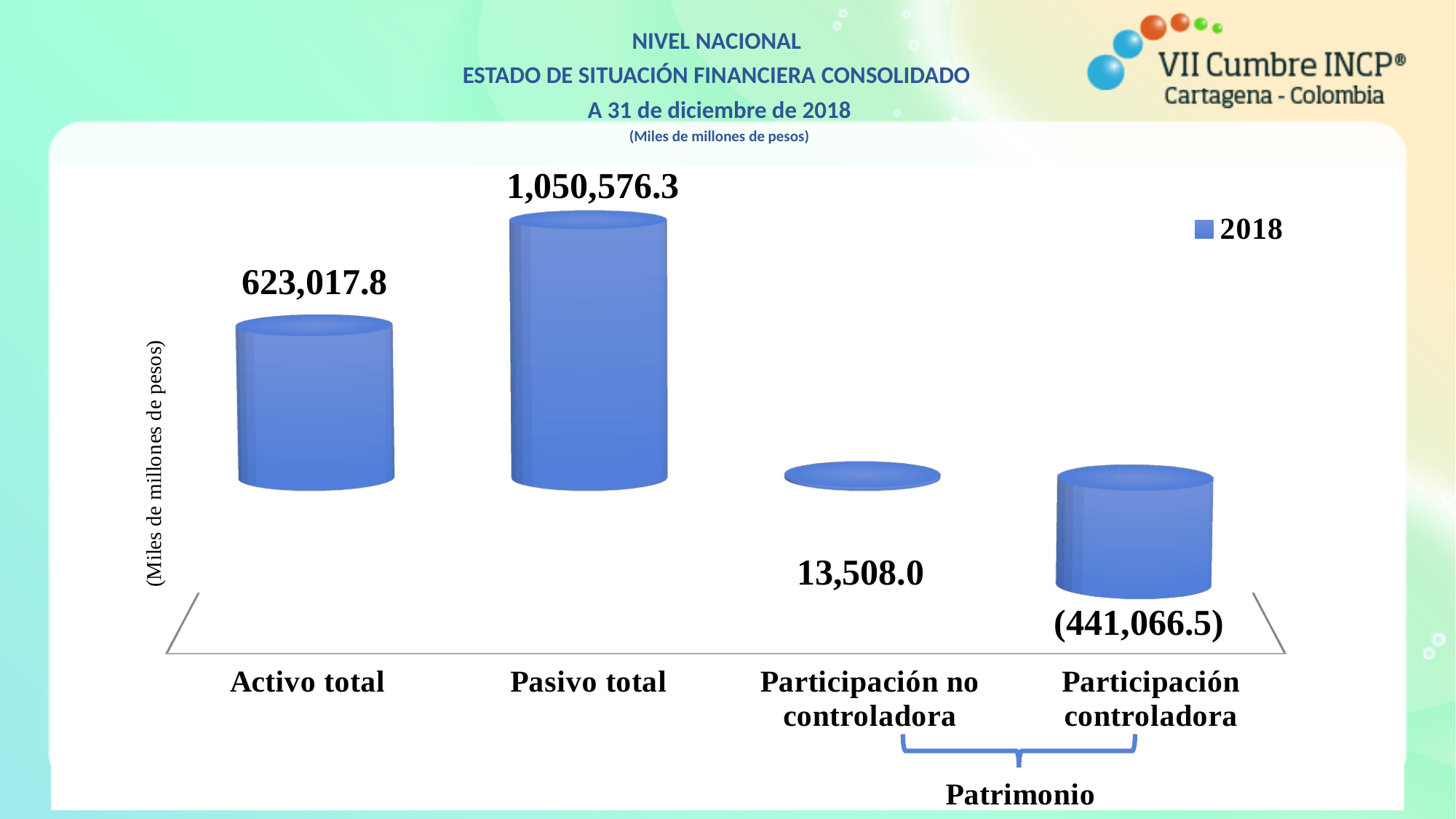
What is the value for Pasivo total? 1,050,576.3 How many series does the legend list? 1 Which category has the highest value? Pasivo total What is the value for Participación controladora? (441,066.5) Which is larger, Activo total or Participación no controladora? Activo total What is the legend entry for the series shown? 2018 What is the value for Participación no controladora? 13,508.0 What kind of chart is shown on the slide? Bar chart How many categories are shown on the x axis? 4 What is the value for Activo total? 623,017.8 Which category has the lowest value? Participación controladora What is the difference between Pasivo total and Activo total? 427,558.5